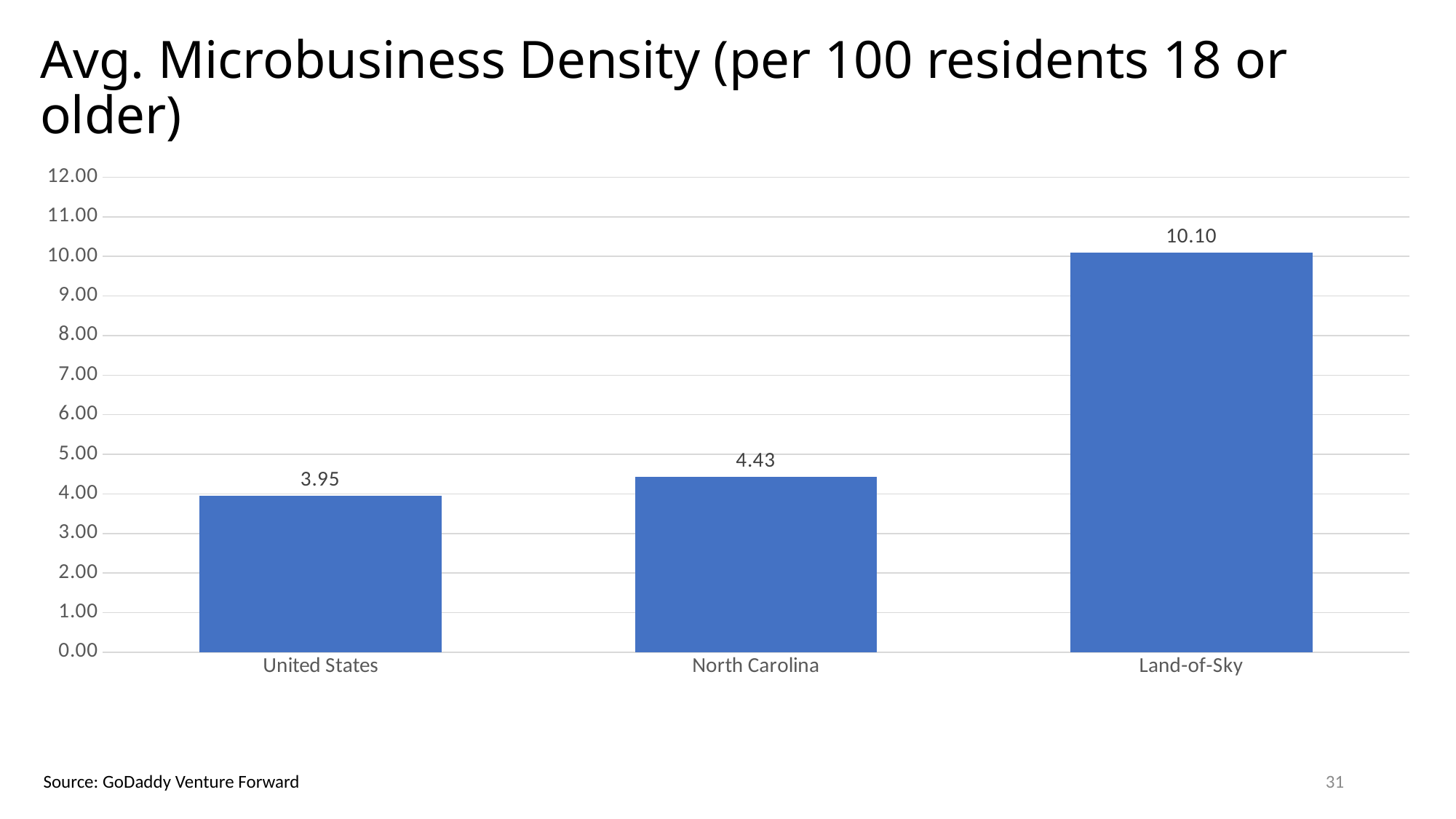
How many categories are shown on the chart? 3 What is the difference between the North Carolina value and the United States value? 0.48 Is the value for Land-of-Sky greater or less than 9.00? greater Which category has the lowest average microbusiness density? United States What kind of chart is shown on the slide? bar chart Which category has the highest average microbusiness density? Land-of-Sky What is the average microbusiness density for North Carolina? 4.43 What is the source cited for the chart? GoDaddy Venture Forward Which is larger, the value for North Carolina or the value for United States? North Carolina What is the difference between the Land-of-Sky value and the North Carolina value? 5.67 What is the average microbusiness density for the United States? 3.95 What is the average microbusiness density for Land-of-Sky? 10.10